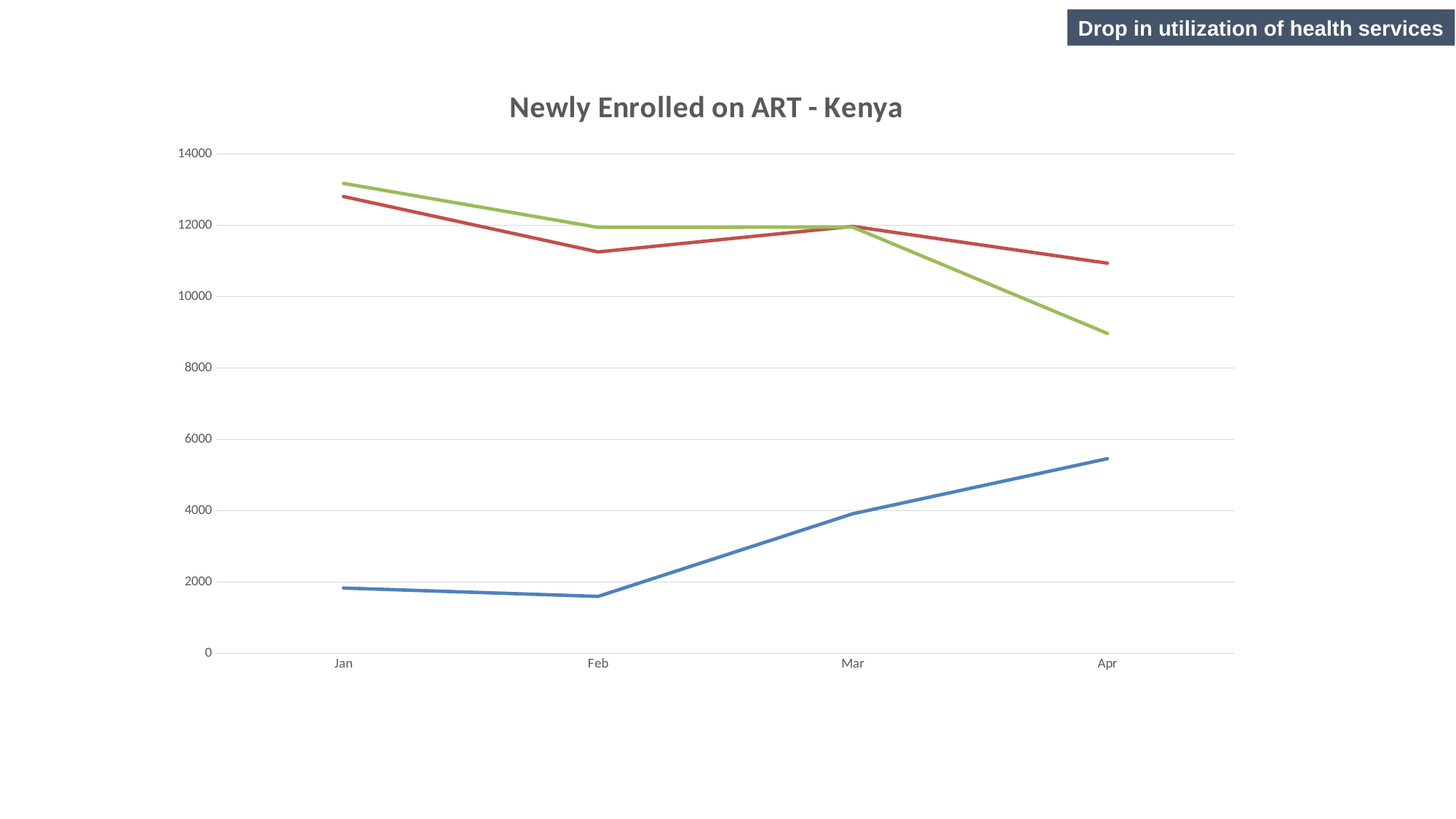
Is the value of the blue line in Apr greater or less than 4000? greater What is the title of the chart? Newly Enrolled on ART - Kenya Does the green line rise or fall from Jan to Apr overall? fall Does the blue line rise or fall from Feb to Apr? rise Is the value of the blue line in Feb greater or less than 2000? less What kind of chart is shown on the slide? line chart Is the value of the red line in Jan greater or less than 12000? greater How many lines are plotted on the chart? 3 In Apr, which line has the higher value, the red line or the green line? red line In which month does the blue line reach its lowest value? Feb How many months are shown on the x axis of the chart? 4